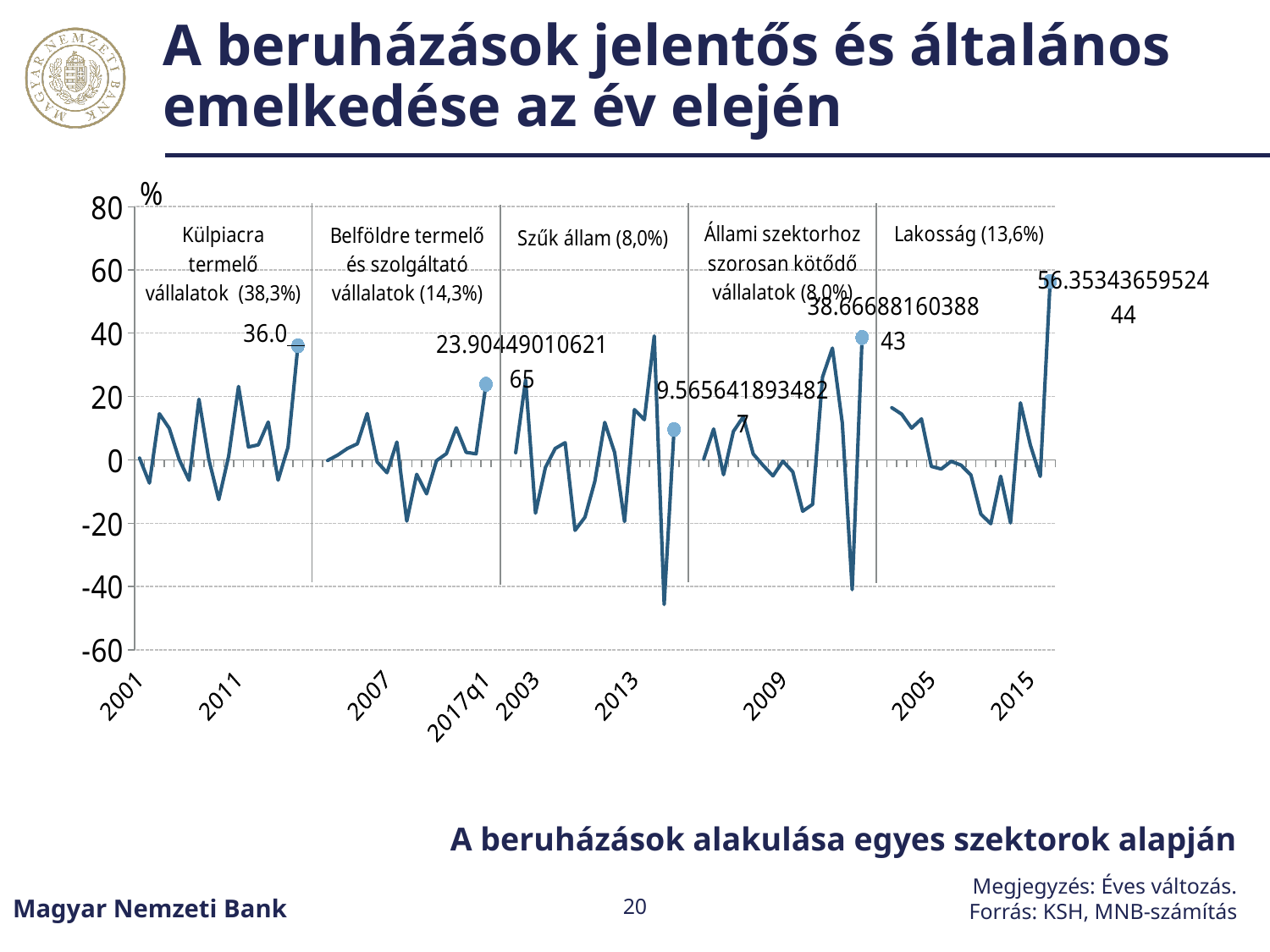
Which is larger: the labelled last point for Külpiacra termelő vállalatok or for Állami szektorhoz szorosan kötődő vállalatok? Állami szektorhoz szorosan kötődő vállalatok Which sector panel has the highest labelled last point? Lakosság Is the highlighted last point in the Lakosság panel greater or less than 40? greater What unit is shown on the vertical axis? % What is the labelled value of the highlighted last point in the Külpiacra termelő vállalatok panel? 36.0 Which sector panel has the lowest labelled last point? Szűk állam What share is shown in parentheses for the Lakosság sector? 13,6% What type of chart is shown on the slide? line chart Is the highlighted last point in the Szűk állam panel greater or less than 20? less How many sector panels does the chart show? 5 Is the highlighted last point in the Állami szektorhoz szorosan kötődő vállalatok panel greater or less than 20? greater What is the title of the chart? A beruházások alakulása egyes szektorok alapján